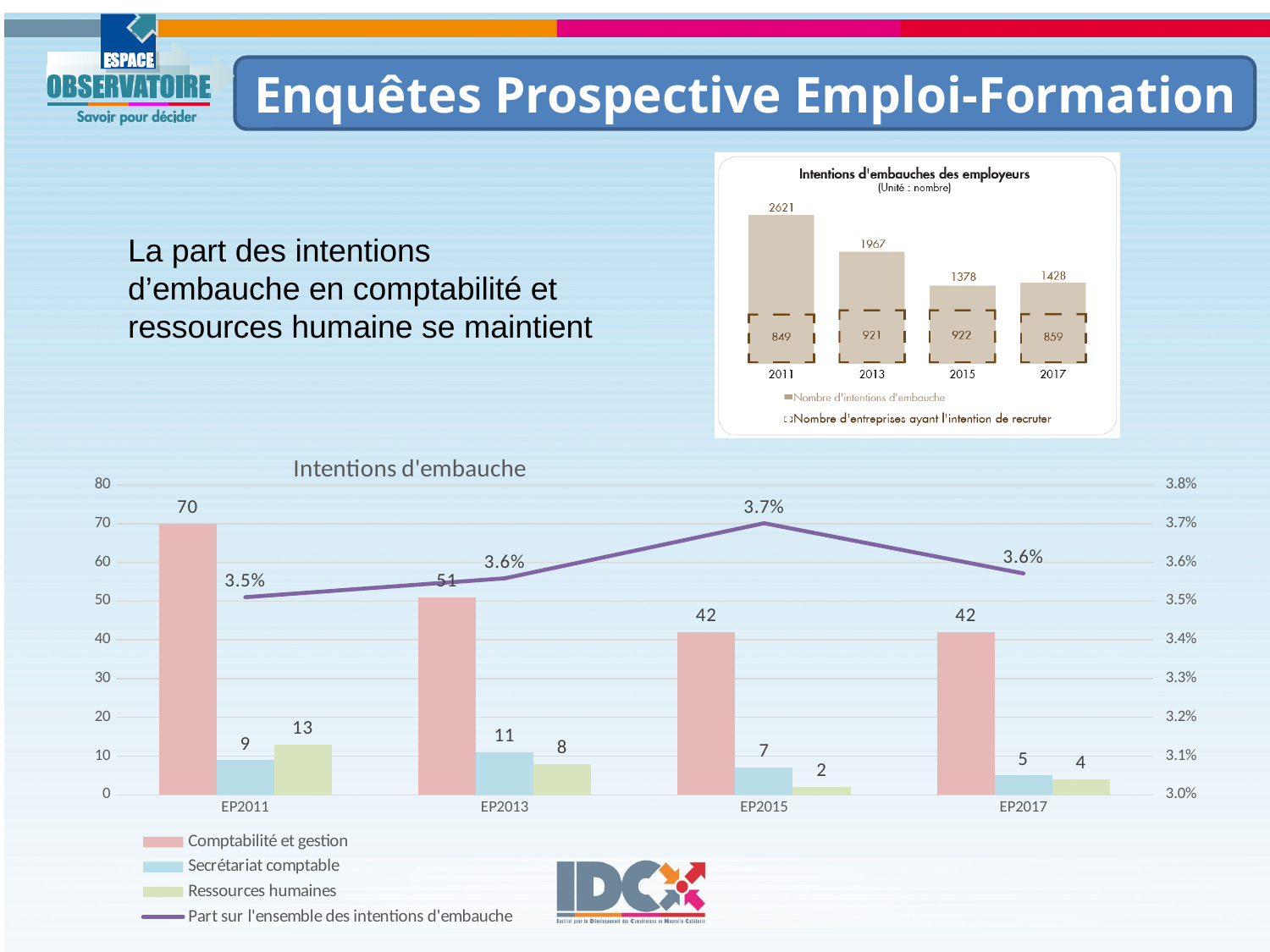
In the 'Intentions d'embauche' chart, what is the difference between the Comptabilité et gestion values for EP2011 and EP2013? 19 In the 'Intentions d'embauche' chart, in which year is 'Part sur l'ensemble des intentions d'embauche' highest? EP2015 In the 'Intentions d'embauches des employeurs' chart, which year has the lowest 'Nombre d'intentions d'embauche'? 2015 In the 'Intentions d'embauche' chart, does the Comptabilité et gestion value rise or fall from EP2011 to EP2015? fall In the 'Intentions d'embauche' chart, what is the value for Ressources humaines in EP2015? 2 What kind of chart is the 'Intentions d'embauches des employeurs' chart? bar chart In the 'Intentions d'embauche' chart, how many series does the legend list? 4 In the 'Intentions d'embauche' chart, what is the value of 'Part sur l'ensemble des intentions d'embauche' in EP2015? 3.7% In the 'Intentions d'embauches des employeurs' chart, what is the 'Nombre d'intentions d'embauche' for 2013? 1967 In the 'Intentions d'embauche' chart, how many categories are shown on the x axis? 4 In the 'Intentions d'embauche' chart, what is the value for Comptabilité et gestion in EP2011? 70 In the 'Intentions d'embauche' chart, which is larger in EP2013: Secrétariat comptable or Ressources humaines? Secrétariat comptable